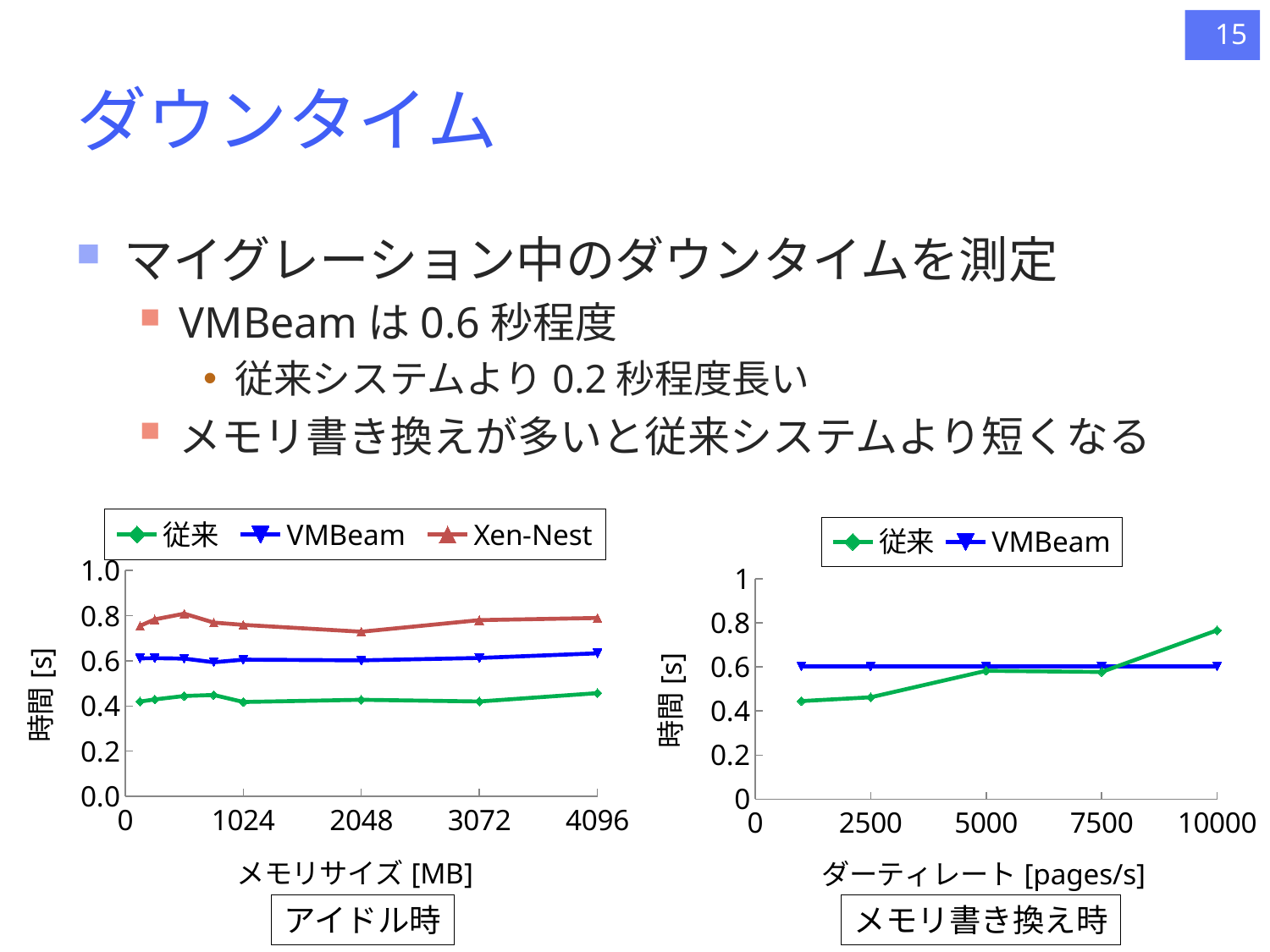
In the right chart (メモリ書き換え時), at 10000 pages/s, which is larger: 従来 or VMBeam? 従来 What is the x-axis label of the right chart (メモリ書き換え時)? ダーティレート [pages/s] How many series does the legend of the left chart (アイドル時) list? 3 In the right chart (メモリ書き換え時), is the value for 従来 at 2500 pages/s greater or less than 0.6? less In the right chart (メモリ書き換え時), does the 従来 line rise or fall as the dirty rate increases? rises In the left chart (アイドル時), is the value for Xen-Nest at 4096 MB greater or less than 0.6? greater How many series does the legend of the right chart (メモリ書き換え時) list? 2 In the left chart (アイドル時), which series has the highest values across the memory sizes? Xen-Nest What kind of chart is the left chart (アイドル時)? line chart In the left chart (アイドル時), which series has the lowest values across the memory sizes? 従来 In the left chart (アイドル時), is the value for 従来 at 2048 MB greater or less than 0.6? less